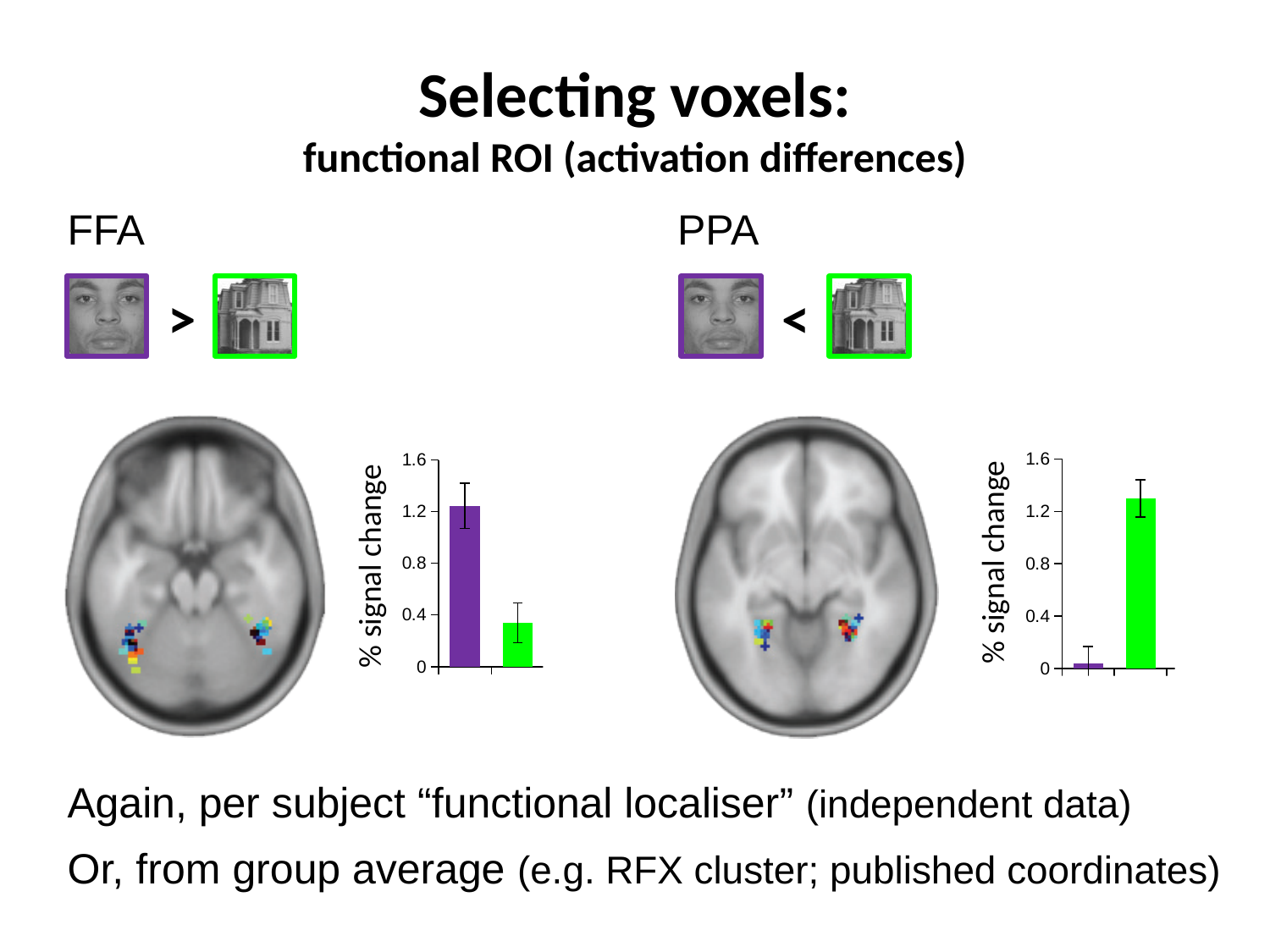
In the PPA chart, is the value of the green bar greater or less than 1.2? greater In the FFA chart, is the value of the purple bar greater or less than 0.8? greater In the PPA chart, which bar is taller, the purple bar or the green bar? the green bar In the FFA chart, which bar has the lowest value? the green bar In the PPA chart, how many bars are plotted? 2 In the FFA chart, what kind of chart is shown? bar chart In the PPA chart, which bar has the highest value? the green bar In the PPA chart, what is the highest value shown on the y axis? 1.6 In the FFA chart, what is the label on the y axis? % signal change In the PPA chart, is the value of the purple bar greater or less than 0.4? less In the FFA chart, which bar is taller, the purple bar or the green bar? the purple bar